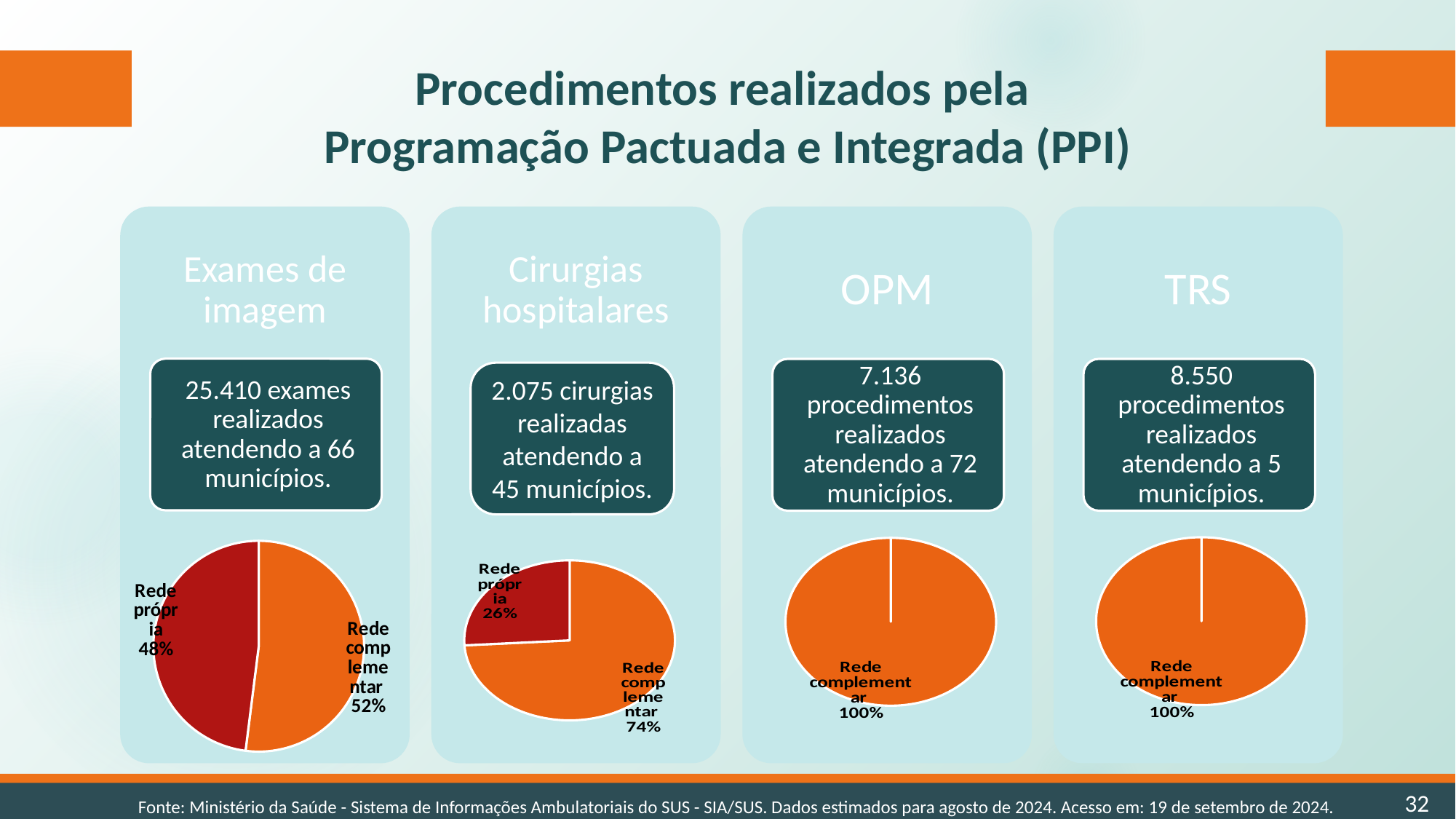
How many slices does the 'Cirurgias hospitalares' pie chart have? 2 In the 'Cirurgias hospitalares' pie chart, what share is labelled for Rede complementar? 74% In the 'Cirurgias hospitalares' pie chart, which slice is the largest? Rede complementar In the 'TRS' pie chart, what share is labelled for Rede complementar? 100% In the 'Cirurgias hospitalares' pie chart, what share is labelled for Rede própria? 26% In the 'Exames de imagem' pie chart, what share is labelled for Rede própria? 48% In the 'Exames de imagem' pie chart, which slice is the smallest? Rede própria In the 'Exames de imagem' pie chart, what share is labelled for Rede complementar? 52% What kind of chart is used under 'OPM'? Pie chart Which is larger in the 'Exames de imagem' pie chart: Rede própria or Rede complementar? Rede complementar In the 'Cirurgias hospitalares' pie chart, what is the difference in percentage points between Rede complementar and Rede própria? 48 In the 'OPM' pie chart, what share is labelled for Rede complementar? 100%